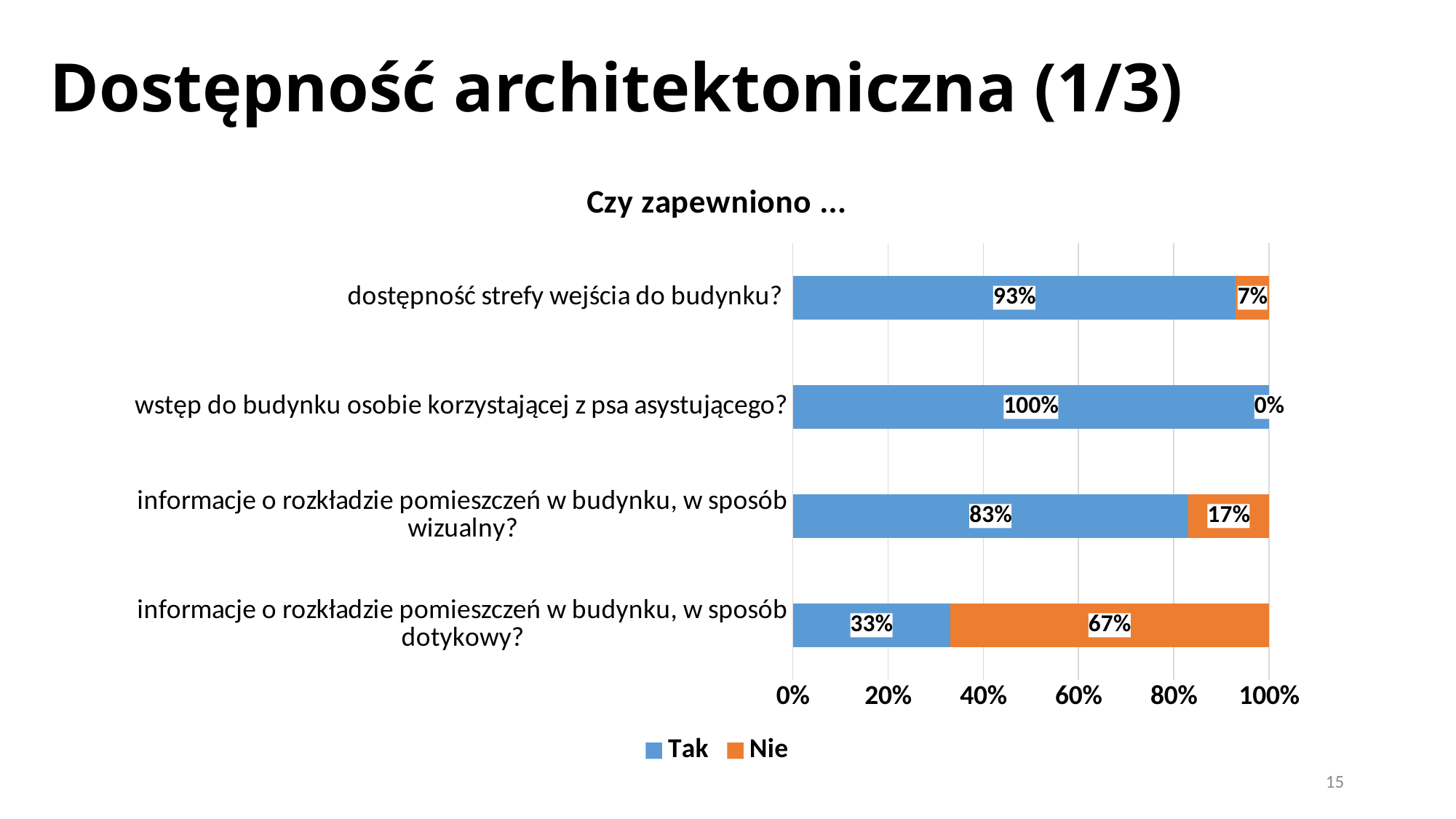
How many series does the legend list? 2 What is the difference between the 'Tak' and 'Nie' values for 'informacje o rozkładzie pomieszczeń w budynku, w sposób dotykowy?' 34% Which category has the lowest 'Tak' value? informacje o rozkładzie pomieszczeń w budynku, w sposób dotykowy? What is the 'Nie' value for 'informacje o rozkładzie pomieszczeń w budynku, w sposób dotykowy?' 67% What is the 'Tak' value for 'dostępność strefy wejścia do budynku?' 93% What kind of chart is shown on the slide? stacked bar chart What is the 'Tak' value for 'informacje o rozkładzie pomieszczeń w budynku, w sposób wizualny?' 83% Which is larger: the 'Nie' value for 'informacje o rozkładzie pomieszczeń w budynku, w sposób wizualny?' or the 'Nie' value for 'dostępność strefy wejścia do budynku?' informacje o rozkładzie pomieszczeń w budynku, w sposób wizualny? What is the title of the chart? Czy zapewniono … How many categories are shown in the chart? 4 Which category has the highest 'Tak' value? wstęp do budynku osobie korzystającej z psa asystującego? What is the 'Nie' value for 'wstęp do budynku osobie korzystającej z psa asystującego?' 0%